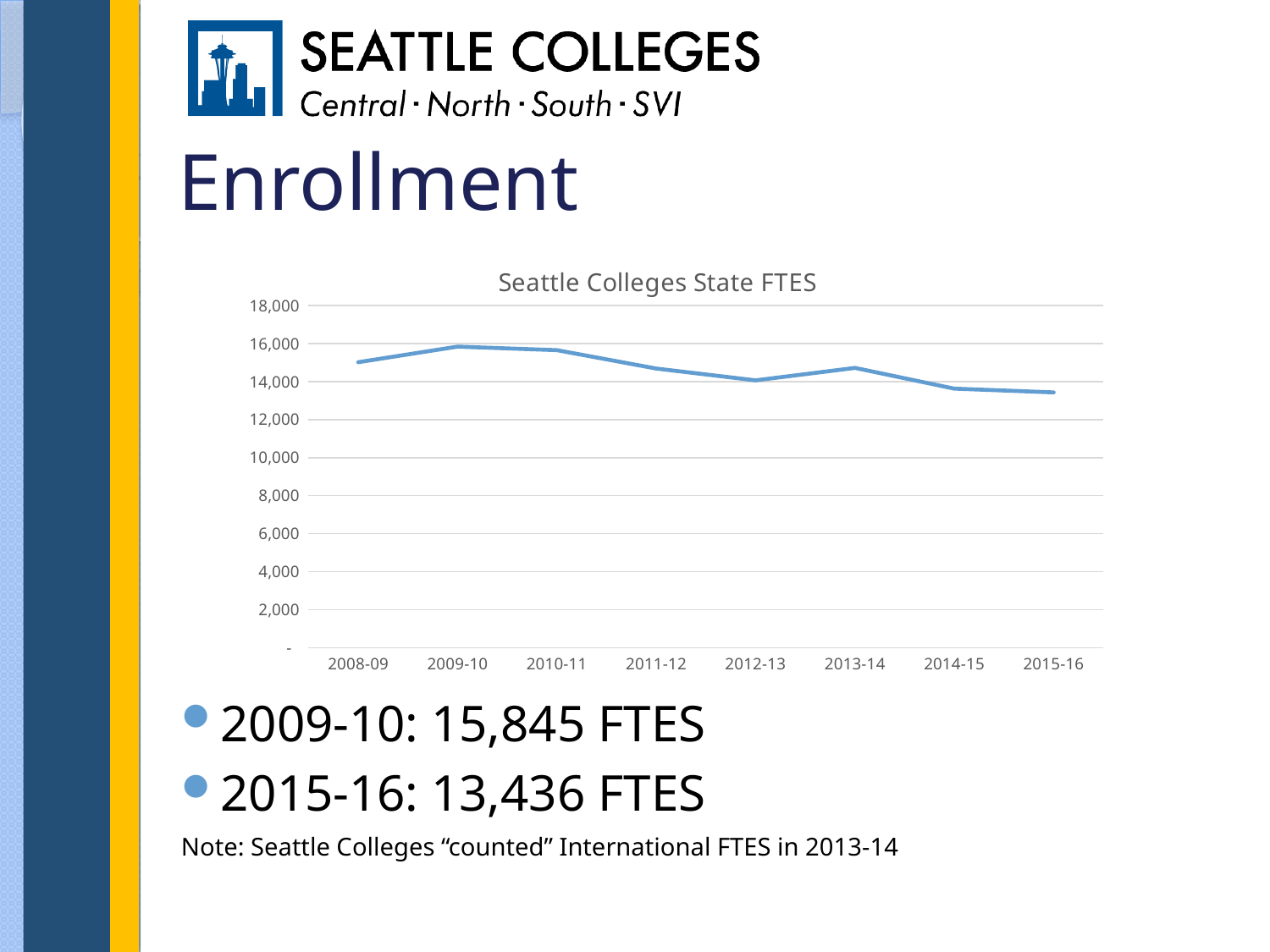
By how much did State FTES decline from 2009-10 to 2015-16? 2,409 FTES Which academic year has the highest State FTES? 2009-10 Overall, do State FTES rise or fall from 2009-10 to 2015-16? fall Is the State FTES value for 2008-09 greater or less than 14,000? greater What is the title of the chart? Seattle Colleges State FTES Is the State FTES value for 2010-11 greater or less than 16,000? less Which is larger, the State FTES for 2013-14 or for 2012-13? 2013-14 Which is larger, the State FTES for 2008-09 or for 2014-15? 2008-09 What is the State FTES value for 2015-16? 13,436 FTES How many academic years are plotted on the x axis of the chart? 8 What kind of chart is shown on the slide? Line chart What is the State FTES value for 2009-10? 15,845 FTES